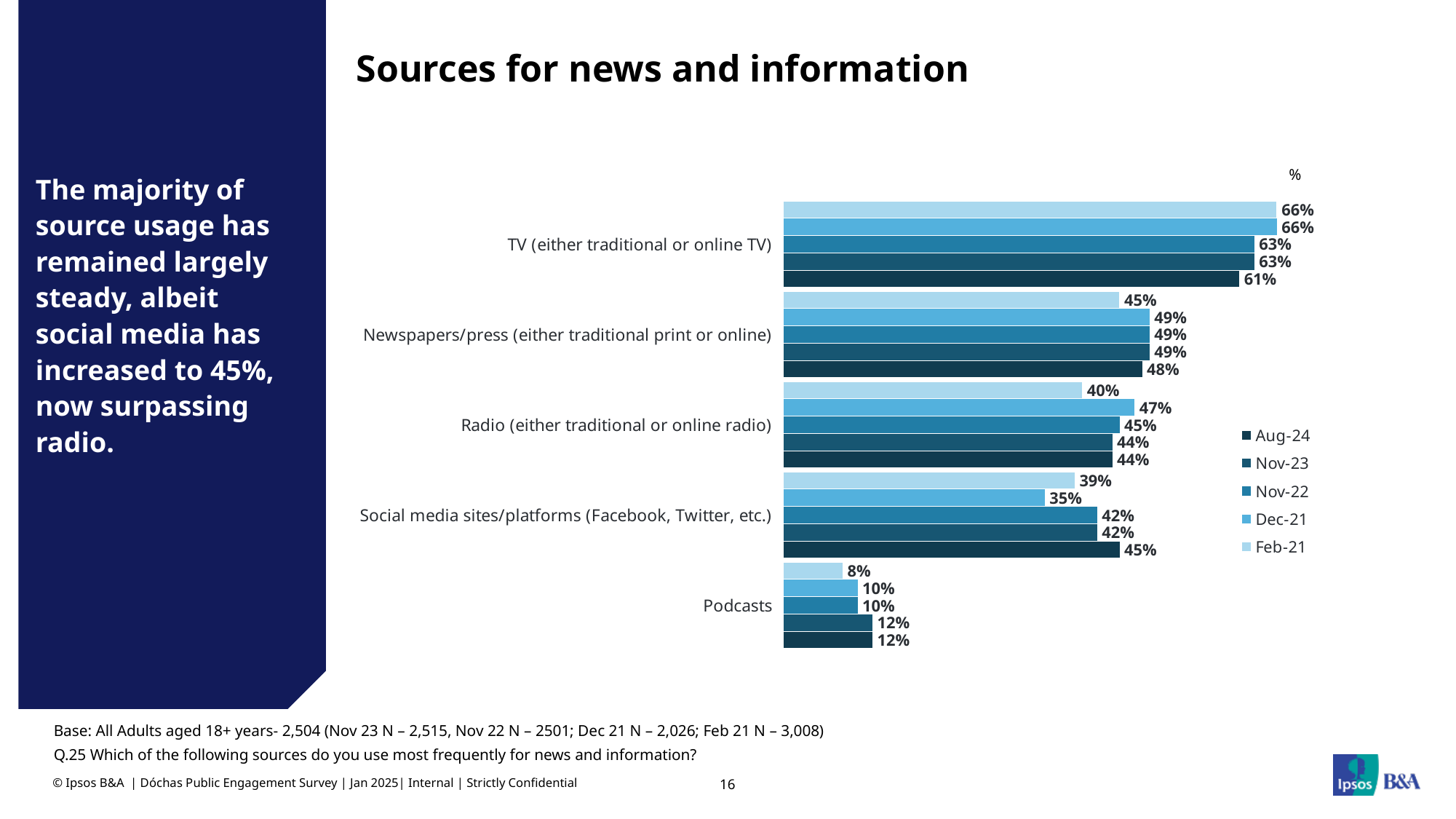
What is the difference between the Feb-21 and Aug-24 values for TV (either traditional or online TV)? 5% What is the Aug-24 value for TV (either traditional or online TV)? 61% What is the Feb-21 value for Podcasts? 8% What is the title of the chart? Sources for news and information Which source has the highest Aug-24 value? TV (either traditional or online TV) In Aug-24, which is larger: the value for Social media sites/platforms or the value for Radio? Social media sites/platforms How many sources (categories) are shown in the chart? 5 What is the Aug-24 value for Social media sites/platforms (Facebook, Twitter, etc.)? 45% How many series does the legend list? 5 What is the Dec-21 value for Radio (either traditional or online radio)? 47% What kind of chart is shown on the slide? Bar chart Which source has the lowest Feb-21 value? Podcasts